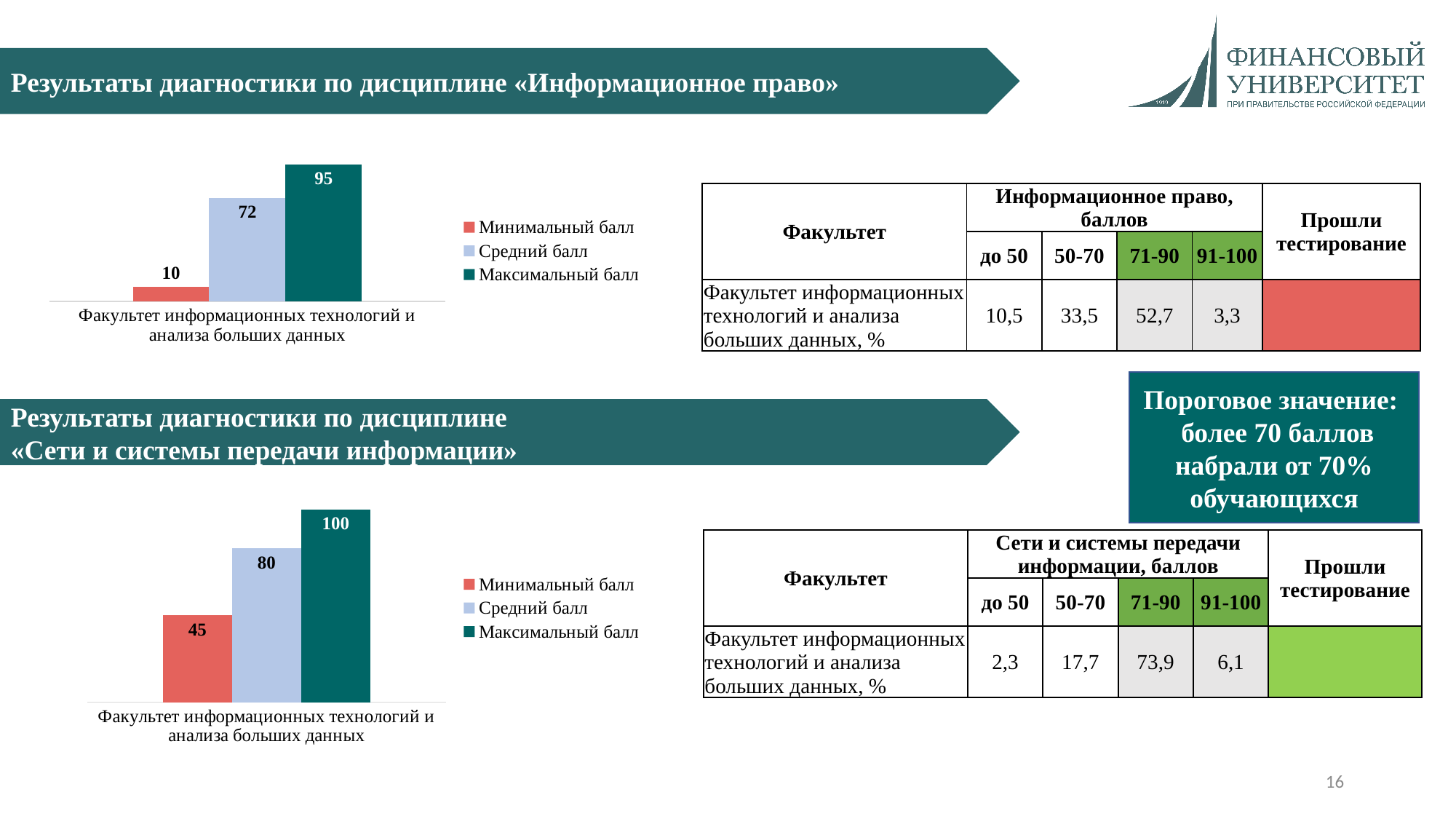
In the top chart (Информационное право), what is the value for Минимальный балл? 10 In the bottom chart (Сети и системы передачи информации), what is the difference between Средний балл and Минимальный балл? 35 In the top chart (Информационное право), what is the value for Средний балл? 72 In the top chart (Информационное право), what is the value for Максимальный балл? 95 In the bottom chart (Сети и системы передачи информации), what is the value for Максимальный балл? 100 How many series does the legend of the top chart (Информационное право) list? 3 In the bottom chart (Сети и системы передачи информации), which series has the lowest value? Минимальный балл Which is larger: Средний балл in the top chart or Средний балл in the bottom chart? Средний балл in the bottom chart What kind of chart is the bottom chart (Сети и системы передачи информации)? Bar chart In the top chart (Информационное право), what is the difference between Максимальный балл and Средний балл? 23 What category label appears on the x axis of the top chart (Информационное право)? Факультет информационных технологий и анализа больших данных In the bottom chart (Сети и системы передачи информации), what is the value for Минимальный балл? 45